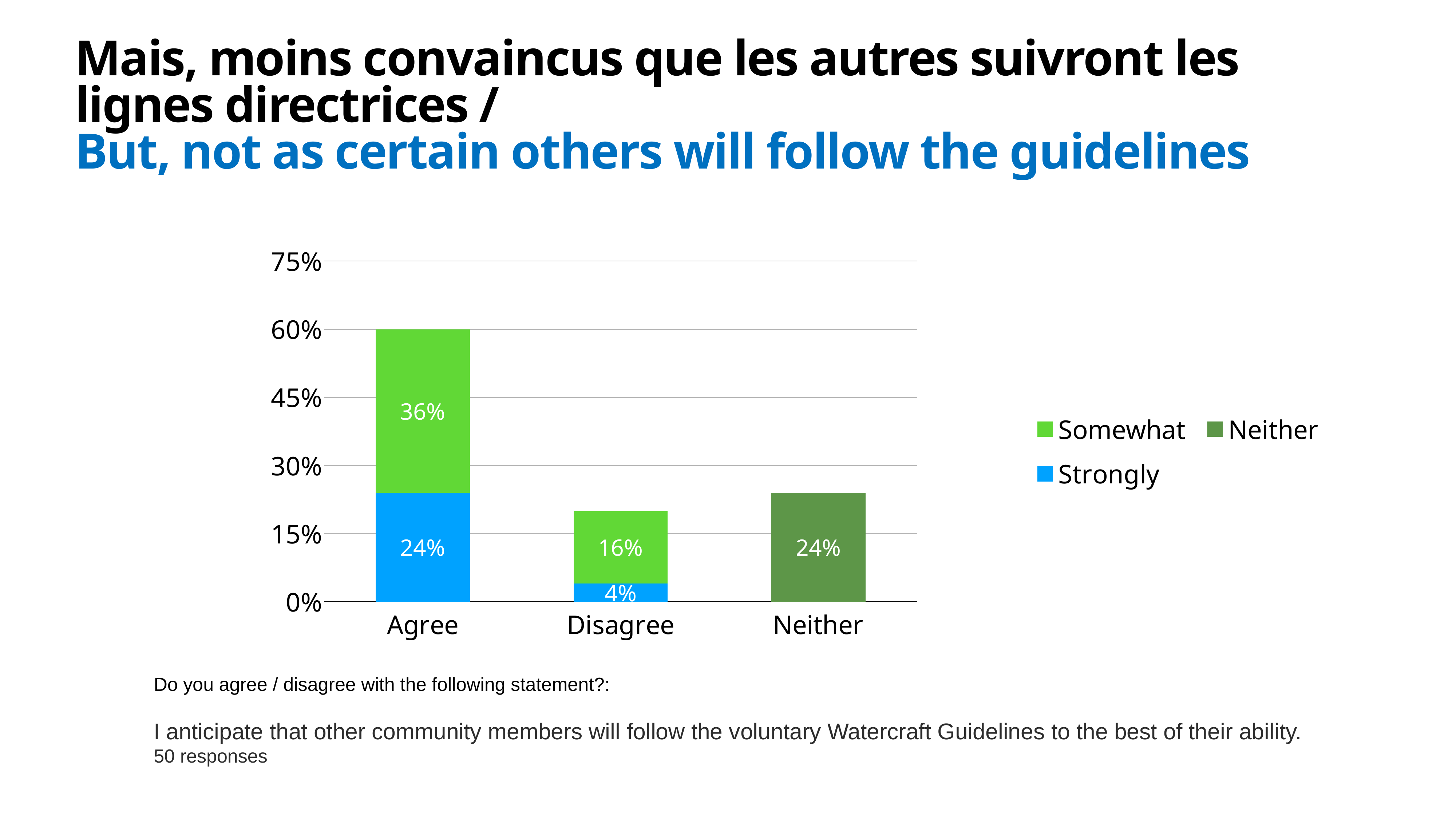
How many categories are shown on the x axis? 3 What is the Strongly value for Agree? 24% What is the total of the stacked Disagree bar? 20% What is the Somewhat value for Agree? 36% Which category has the lowest total bar? Disagree What is the Strongly value for Disagree? 4% What is the total of the stacked Agree bar? 60% What is the difference between the Somewhat value for Agree and the Somewhat value for Disagree? 20% How many series does the legend list? 3 What is the Somewhat value for Disagree? 16% What is the value for the Neither bar? 24% Which category has the highest total bar? Agree